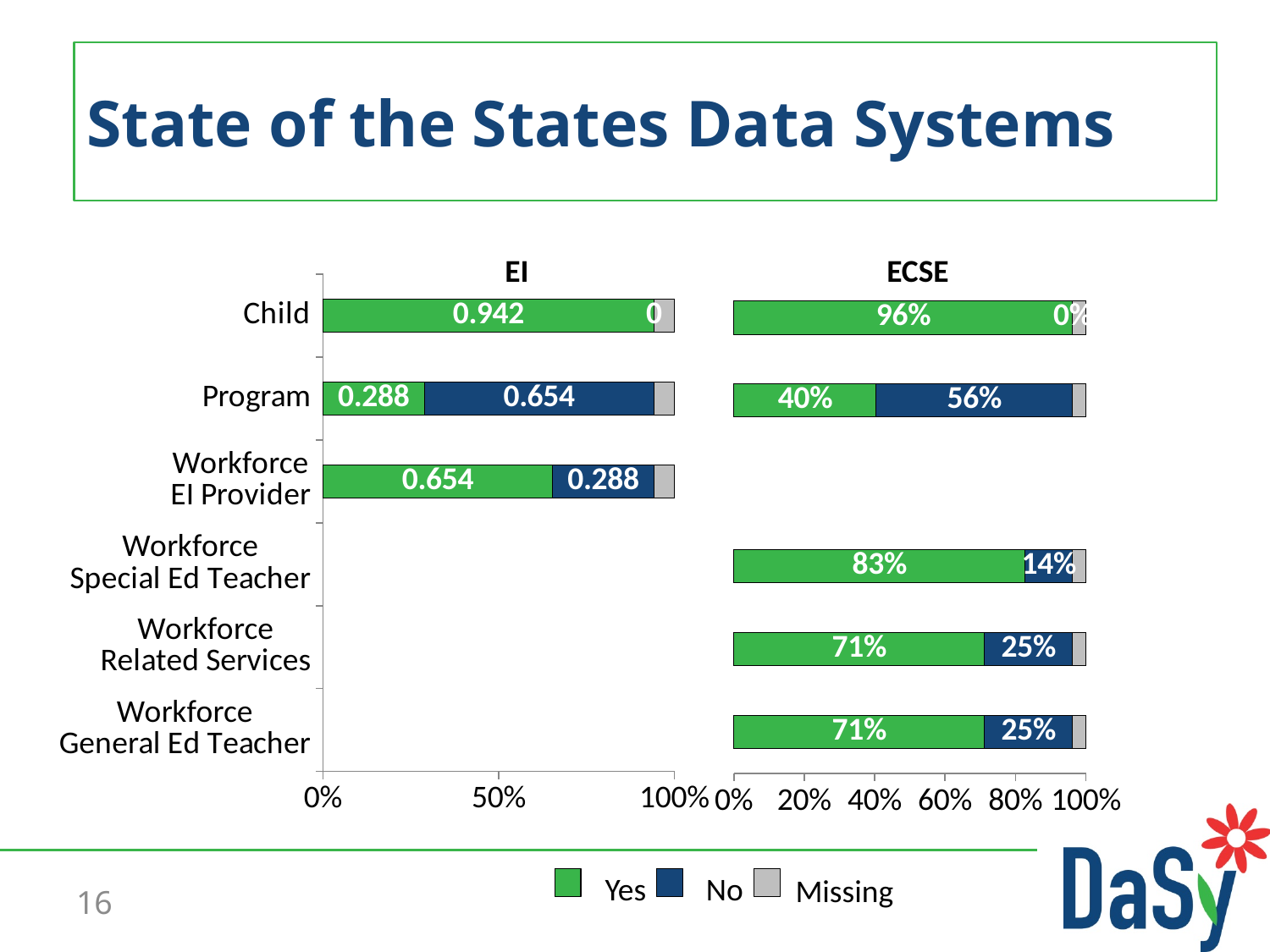
In the ECSE chart, what is the No value for Program? 56% In the EI chart, which has the larger Yes value: Program or Workforce EI Provider? Workforce EI Provider In the EI chart, what is the No value for Program? 0.654 How many categories have bars in the ECSE chart? 5 In the ECSE chart, what is the difference between the No value for Workforce Related Services and the No value for Workforce Special Ed Teacher? 11% In the ECSE chart, which category has the lowest Yes value? Program What kind of chart is the ECSE chart? Bar chart How many series does the legend list? 3 In the ECSE chart, what is the Yes value for Workforce Special Ed Teacher? 83% In the ECSE chart, what is the difference between the Yes value for Child and the Yes value for Program? 56% In the ECSE chart, which category has the highest Yes value? Child In the EI chart, what is the Yes value for Child? 0.942